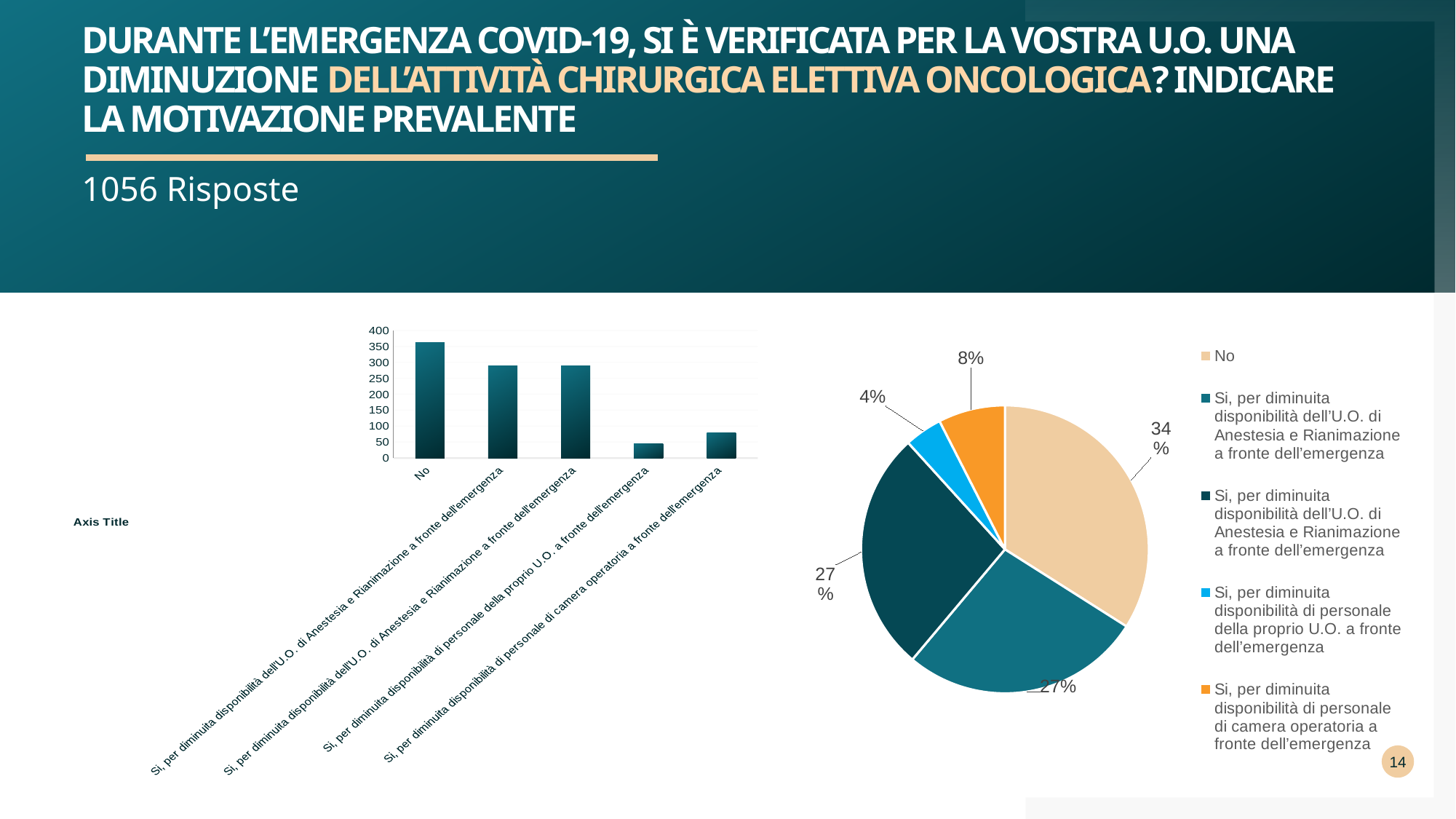
In the bar chart on the left, which is larger: the bar for 'personale di camera operatoria' or the bar for 'personale della proprio U.O.'? Si, per diminuita disponibilità di personale di camera operatoria a fronte dell'emergenza In the pie chart, what share is 'Si, per diminuita disponibilità di personale di camera operatoria a fronte dell'emergenza'? 8% In the pie chart, which category has the smallest slice? Si, per diminuita disponibilità di personale della proprio U.O. a fronte dell'emergenza In the bar chart on the left, which category has the tallest bar? No In the pie chart, which category has the largest slice? No In the bar chart on the left, is the value for 'No' greater or less than 350? greater In the pie chart, how many entries does the legend list? 5 In the pie chart, what share of responses is 'No'? 34% In the pie chart, how many percentage points larger is the 'No' slice than the 'personale di camera operatoria' slice? 26 percentage points In the bar chart on the left, how many bars are plotted? 5 In the pie chart, what share is 'Si, per diminuita disponibilità di personale della proprio U.O. a fronte dell'emergenza'? 4% What kind of chart is the chart on the left of the slide? Bar chart